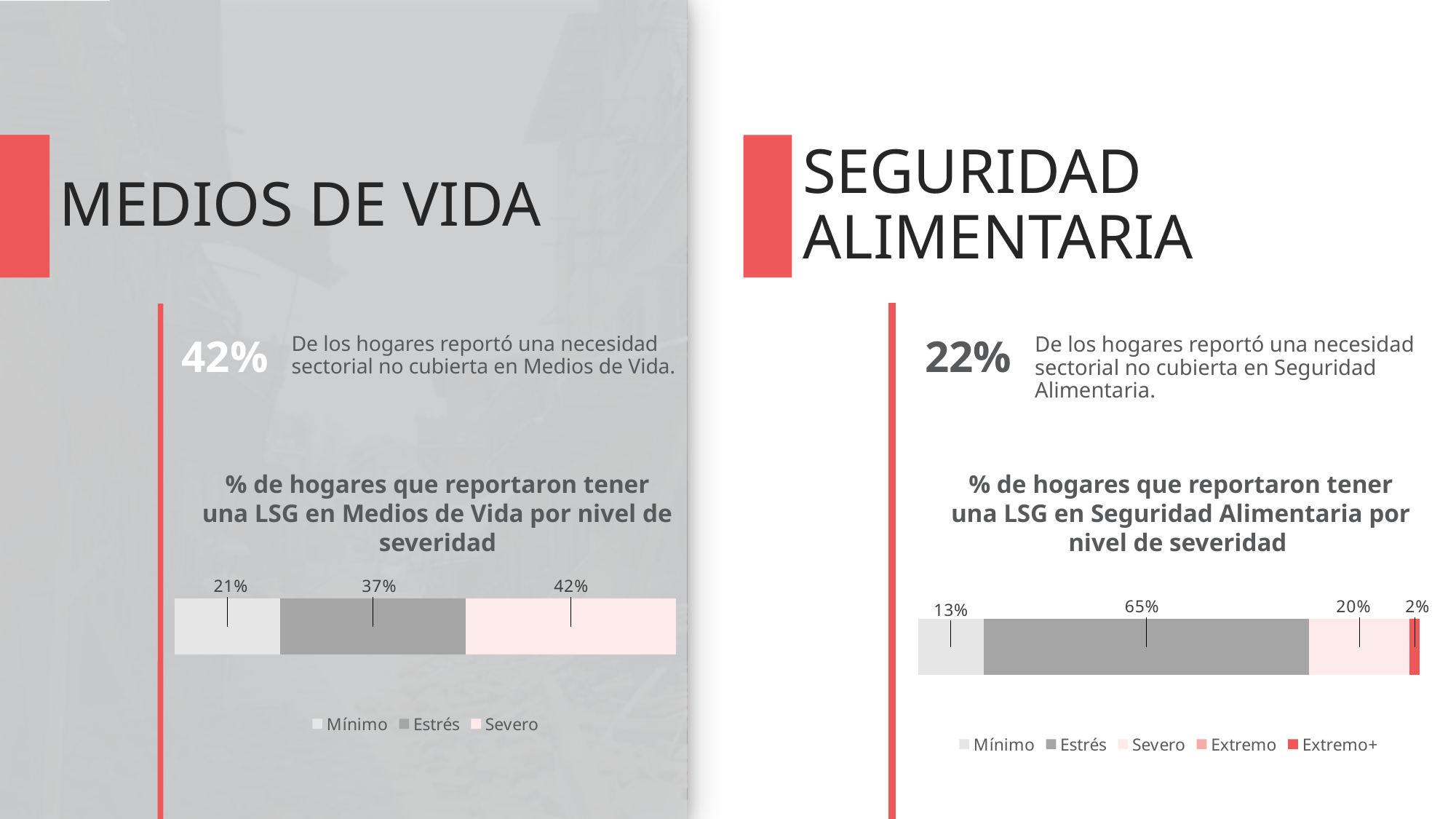
What type of chart is used on the Seguridad Alimentaria side of the slide? Stacked bar chart On the Seguridad Alimentaria chart, which is larger, the Severo percentage or the Mínimo percentage? Severo On the Seguridad Alimentaria chart, how many series does the legend list? 5 On the Seguridad Alimentaria chart, what percentage of households is shown for the Mínimo level? 13% On the Medios de Vida chart, what percentage of households is shown for the Estrés level? 37% On the Medios de Vida chart, what is the difference between the Severo and Mínimo percentages? 21 percentage points On the Seguridad Alimentaria chart, what is the difference between the Estrés and Severo percentages? 45 percentage points On the Seguridad Alimentaria chart, which severity level has the highest percentage? Estrés On the Medios de Vida chart, which severity level has the highest percentage? Severo On the Medios de Vida chart, what percentage of households is shown for the Mínimo level? 21% On the Seguridad Alimentaria chart, what percentage of households is shown for the Estrés level? 65% On the Medios de Vida chart, how many series does the legend list? 3